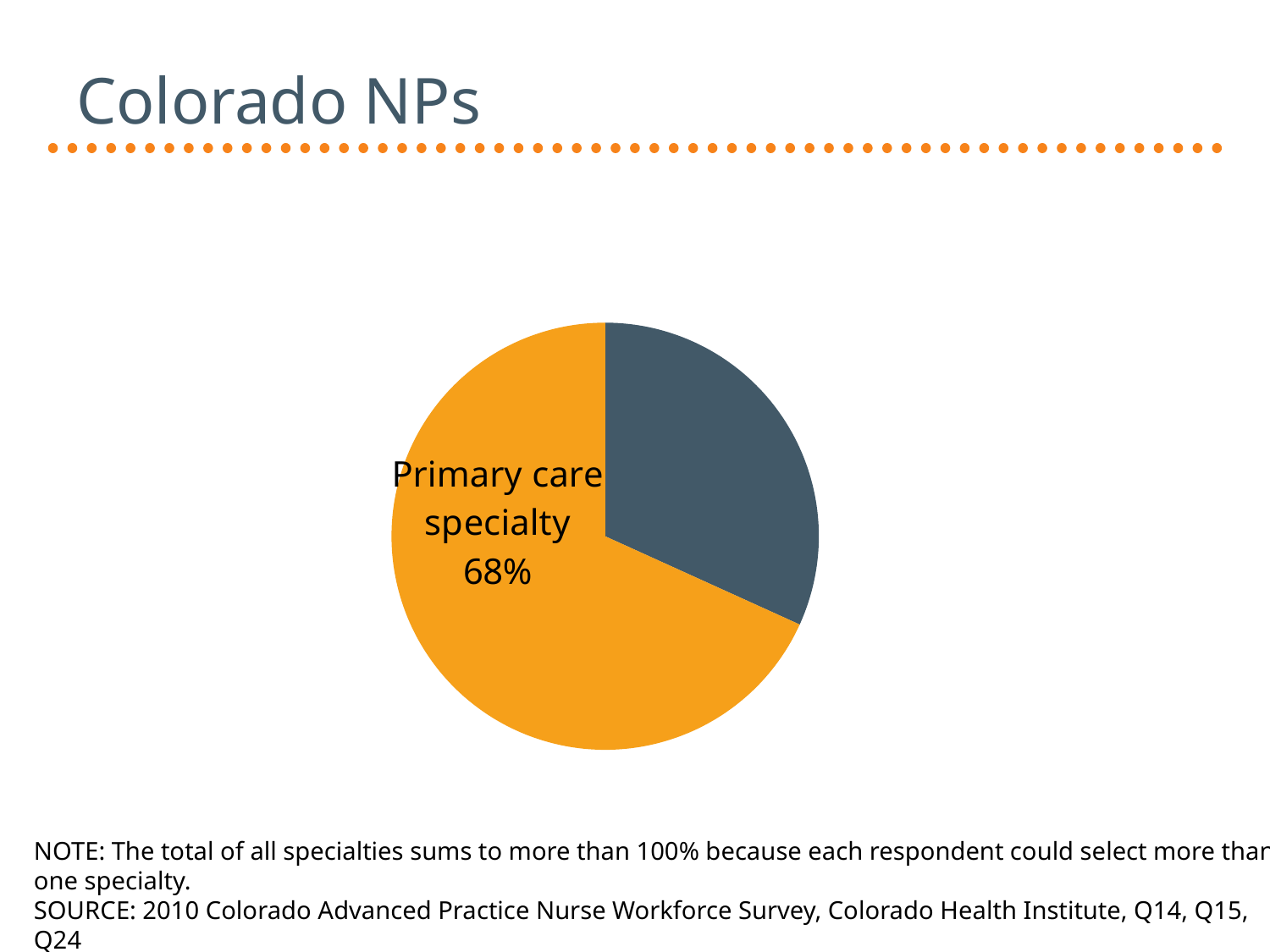
What percentage of the pie is labelled "Primary care specialty"? 68% Is the "Primary care specialty" slice greater or less than 50% of the pie? greater What is the title of the slide containing the pie chart? Colorado NPs What kind of chart is shown on the slide? pie chart How many slices does the pie chart have? 2 What colour is the "Primary care specialty" slice? orange Which slice of the pie chart is the largest? Primary care specialty Which slice of the pie chart is larger, the "Primary care specialty" slice or the unlabelled dark slice? Primary care specialty